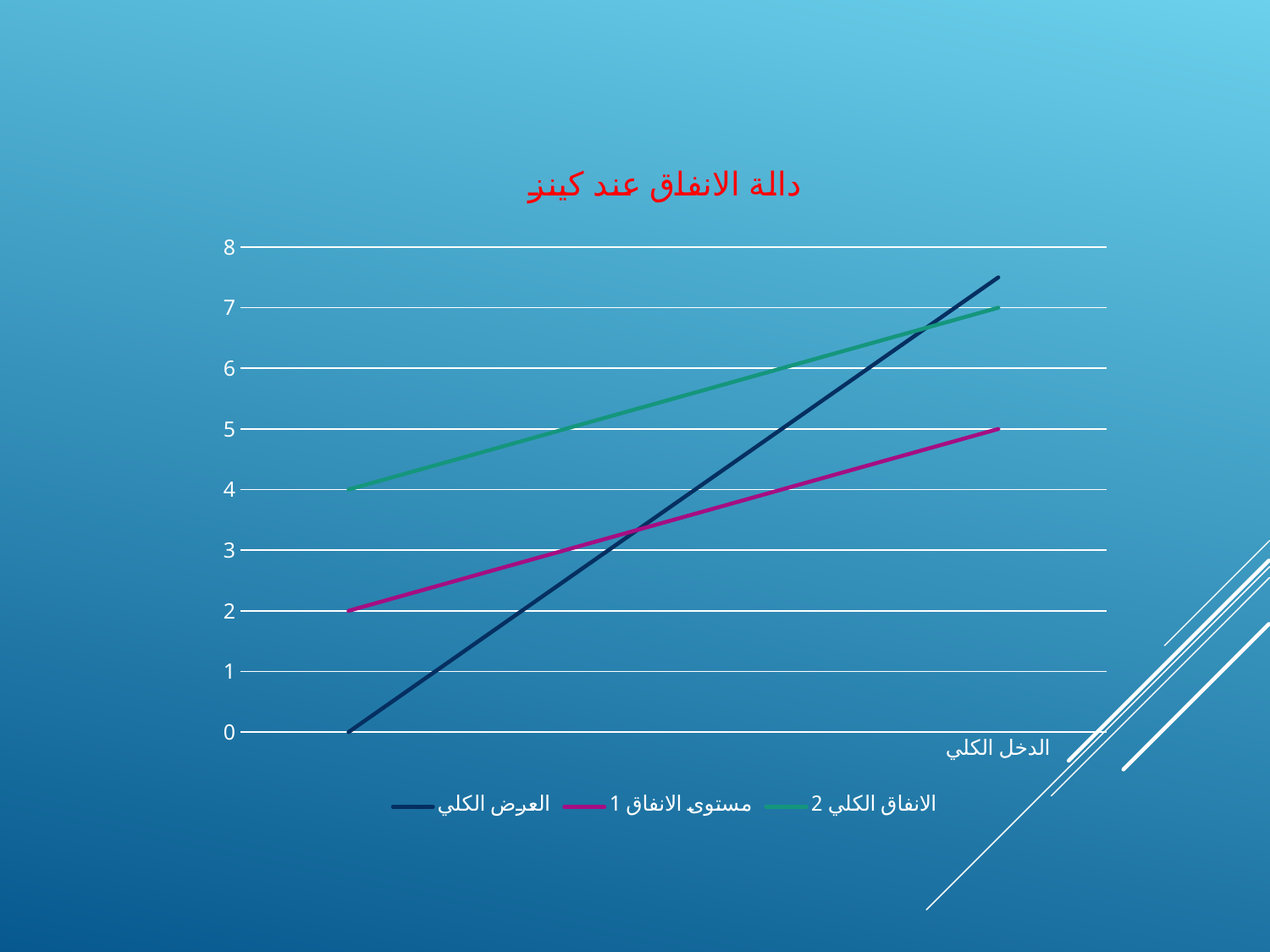
How many series does the legend list? 3 By how much does the الانفاق الكلي 2 line increase from its left end to its right end? 3 What is the value of the مستوى الانفاق 1 line at its left end? 2 What is the title of the chart? دالة الانفاق عند كينز Do the lines rise or fall from left to right? rise What kind of chart is shown on the slide? line chart Which series has the lowest value at the left end of the chart? العرض الكلي What is the label on the horizontal axis? الدخل الكلي What is the value of the مستوى الانفاق 1 line at its right end? 5 What is the value of the الانفاق الكلي 2 line at its left end? 4 Is the value of the العرض الكلي line at its right end greater or less than 7? greater What is the value of the الانفاق الكلي 2 line at its right end? 7